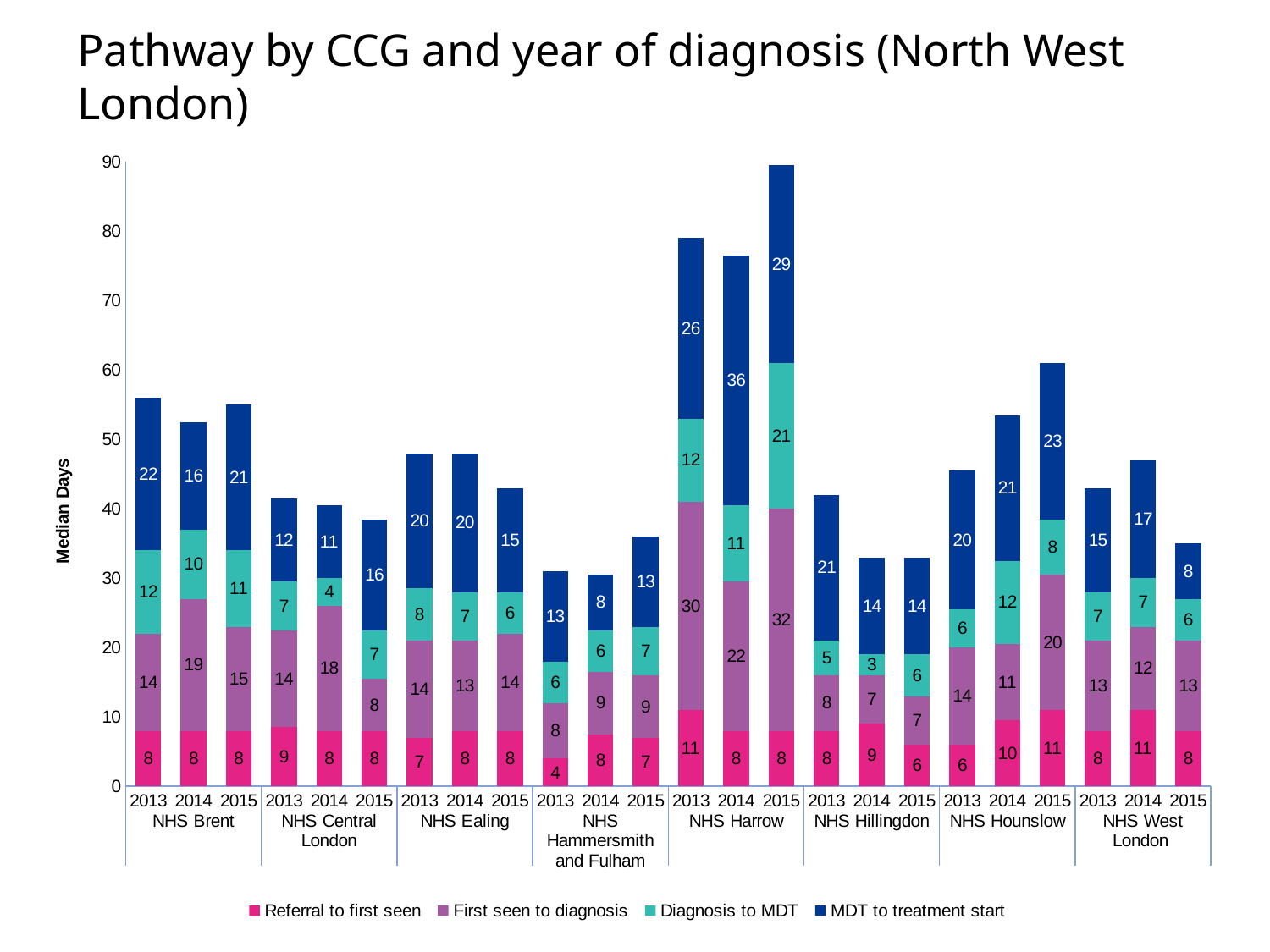
What kind of chart is shown on the slide? Stacked bar chart Which is larger for First seen to diagnosis in 2014: NHS Brent or NHS Central London? NHS Brent What is the total median days for the NHS Harrow 2013 stacked bar? 79 What is the difference in MDT to treatment start between NHS Harrow 2015 and NHS Harrow 2013? 3 What is the median days for Diagnosis to MDT for NHS Hounslow in 2014? 12 How many CCGs are shown on the x axis? 8 Which CCG and year has the lowest value for Referral to first seen? NHS Hammersmith and Fulham 2013 Is the total for NHS Hammersmith and Fulham 2013 greater or less than 40? less How many series does the legend list? 4 Which CCG and year has the tallest stacked bar overall? NHS Harrow 2015 What is the median days for MDT to treatment start for NHS Harrow in 2014? 36 What is the median days for First seen to diagnosis for NHS Harrow in 2015? 32